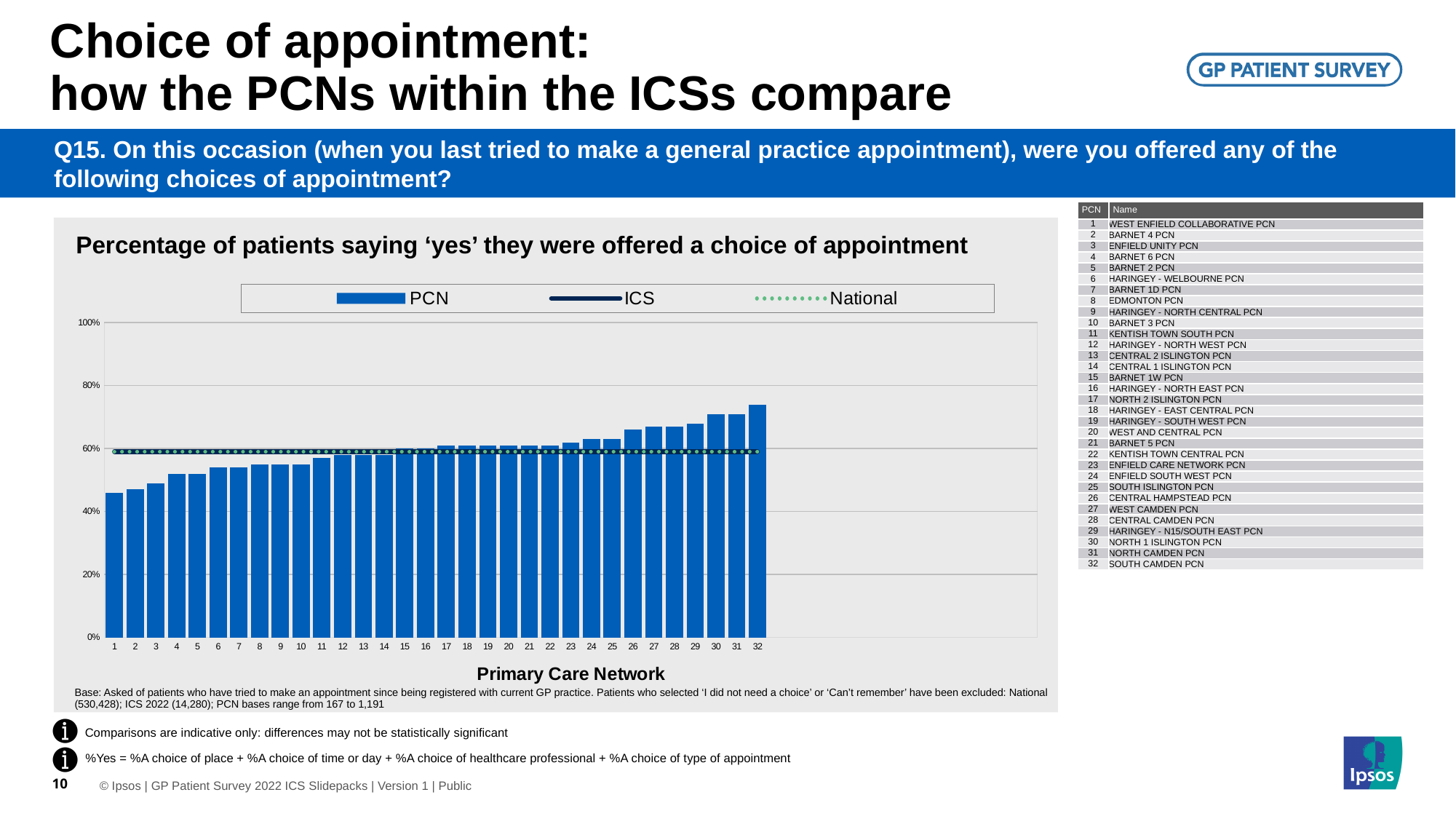
Is the value for PCN 1 greater or less than 40%? greater What is the title of the x axis of the chart? Primary Care Network What kind of chart is used to show the percentage of patients offered a choice of appointment by PCN? bar chart Which PCN has the highest percentage of patients saying 'yes' they were offered a choice of appointment? 32 How many series does the chart legend list? 3 How many Primary Care Networks are plotted on the x axis of the chart? 32 Is the value for PCN 10 greater or less than 60%? less Is the value for PCN 30 greater or less than 60%? greater Which PCN has the lowest percentage of patients saying 'yes' they were offered a choice of appointment? 1 Which has the larger value, PCN 5 or PCN 28? PCN 28 Do the PCN bar values rise or fall moving from PCN 1 to PCN 32 along the x axis? rise